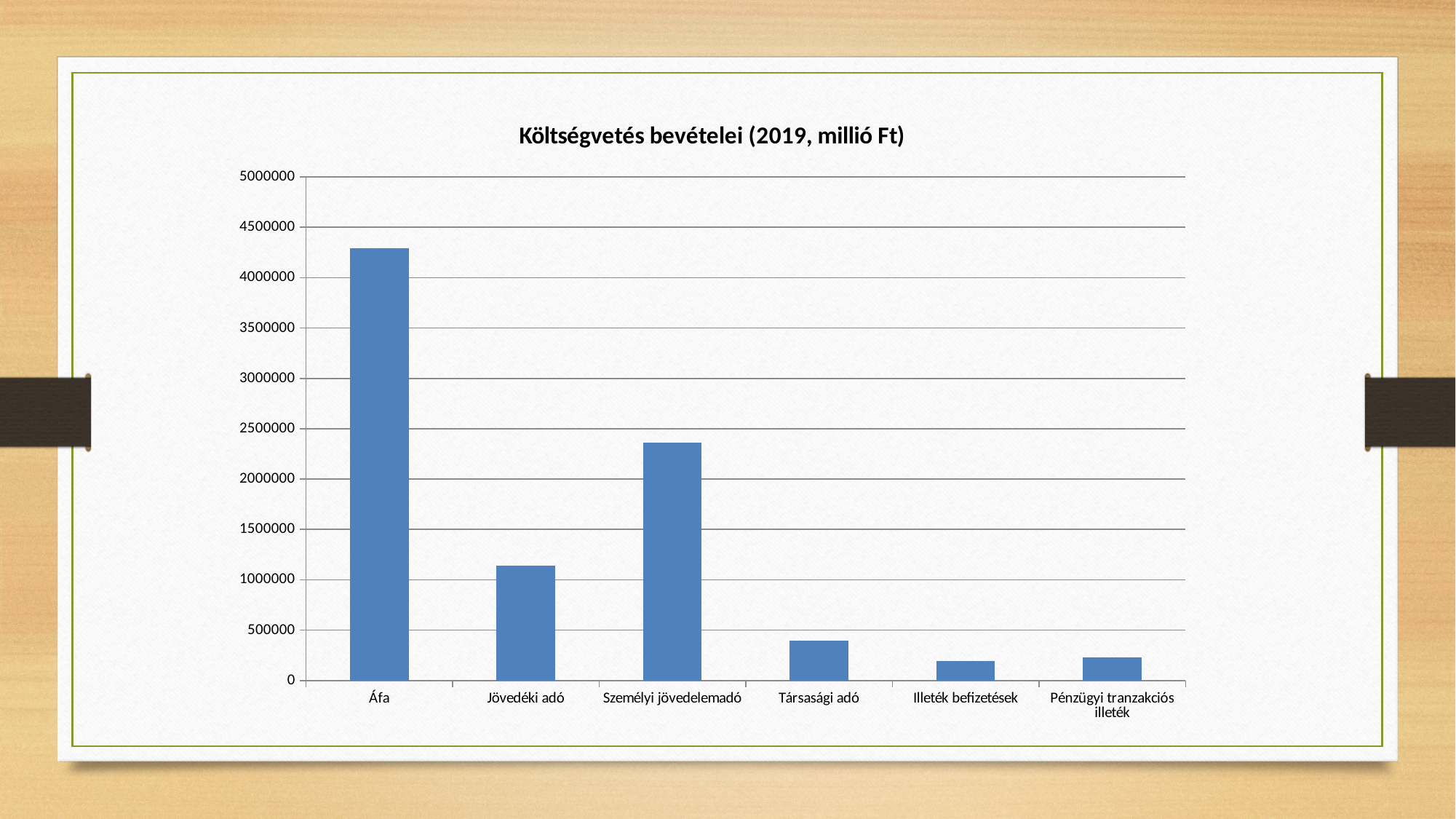
What kind of chart is shown on the slide? bar chart Is the value for Áfa greater or less than 4000000? greater Is the value for Illeték befizetések greater or less than 500000? less Is the value for Jövedéki adó greater or less than 1000000? greater What is the title of the chart? Költségvetés bevételei (2019, millió Ft) How many categories are shown on the x axis of the chart? 6 Which is larger, the value for Társasági adó or the value for Áfa? Áfa Which is larger, the value for Személyi jövedelemadó or the value for Jövedéki adó? Személyi jövedelemadó What is the highest value shown on the y axis of the chart? 5000000 Which category has the highest value in the chart? Áfa